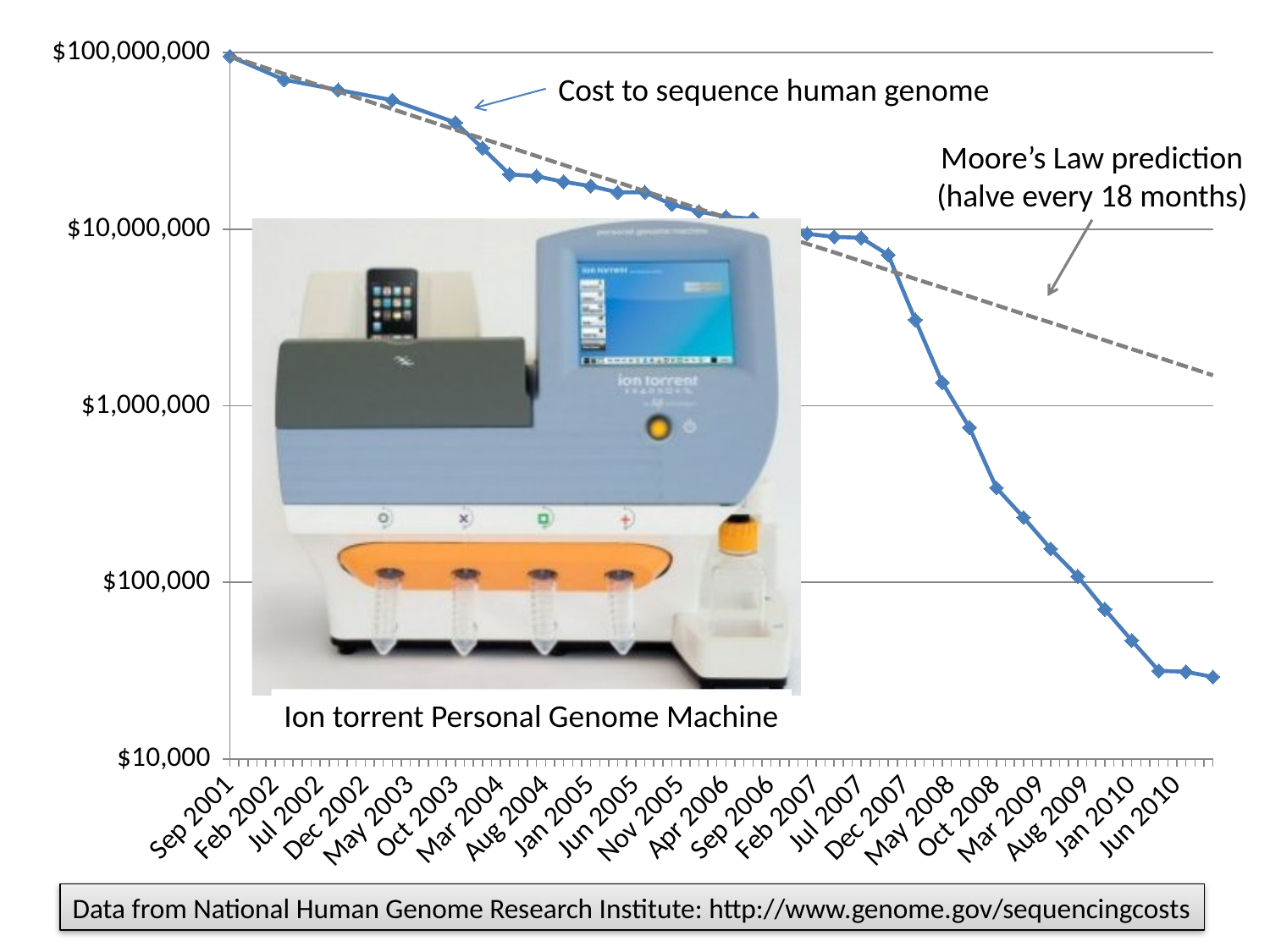
Which is larger: the cost to sequence a human genome in Sep 2001 or in Jun 2010? Sep 2001 What kind of chart is shown on the slide? line chart Is the Moore's Law prediction at the right end of the chart greater or less than $1,000,000? greater Is the cost to sequence a human genome in Jun 2010 greater or less than $100,000? less Which is higher at the right end of the chart: the actual cost to sequence a human genome or the Moore's Law prediction? Moore's Law prediction Does the cost to sequence a human genome rise or fall from Sep 2001 to Jun 2010? fall What is the source of the data cited at the bottom of the slide? National Human Genome Research Institute: http://www.genome.gov/sequencingcosts Is the cost to sequence a human genome in Sep 2001 greater or less than $10,000,000? greater How many lines are plotted on the chart? 2 According to the annotation, how often does the Moore's Law prediction halve the cost? every 18 months